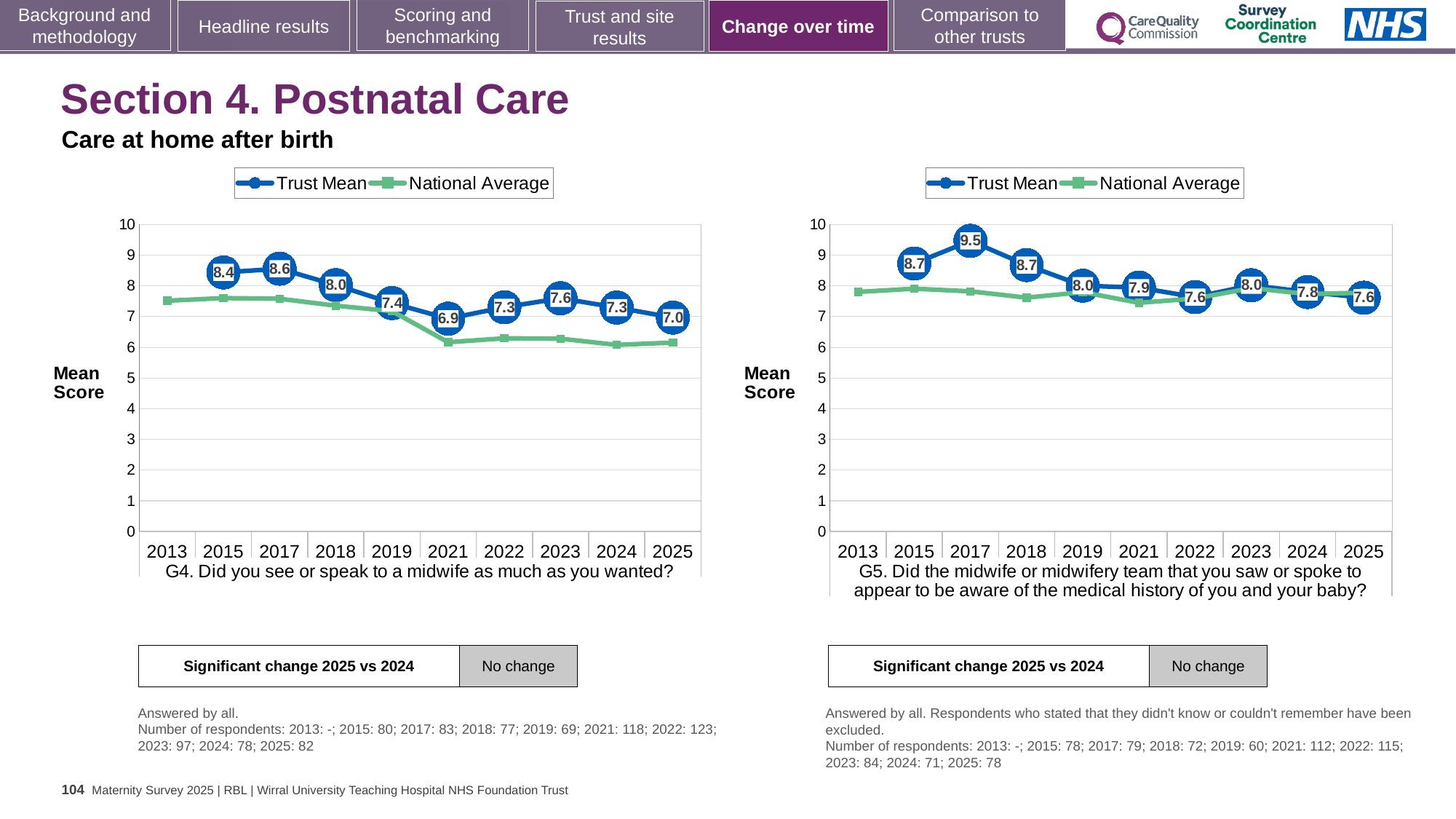
How many series does the legend of the G4 chart on the left list? 2 In the G5 chart on the right, what is the difference between the Trust Mean scores for 2017 and 2022? 1.9 What kind of chart is the G5 chart on the right? Line chart In the G4 chart on the left, is the Trust Mean score higher in 2023 or in 2024? 2023 In the G4 chart on the left, what is the Trust Mean score for 2017? 8.6 In the G5 chart on the right, what is the Trust Mean score for 2025? 7.6 In the G5 chart on the right, which year has the highest Trust Mean score? 2017 How many years are shown on the x axis of the G5 chart on the right? 10 In the G4 chart on the left, is the National Average value for 2021 greater or less than 7? less In the G4 chart on the left, does the Trust Mean score rise or fall from 2017 to 2021? Fall In the G4 chart on the left, which year has the lowest Trust Mean score? 2021 In the G4 chart on the left, what is the difference between the Trust Mean scores for 2017 and 2025? 1.6